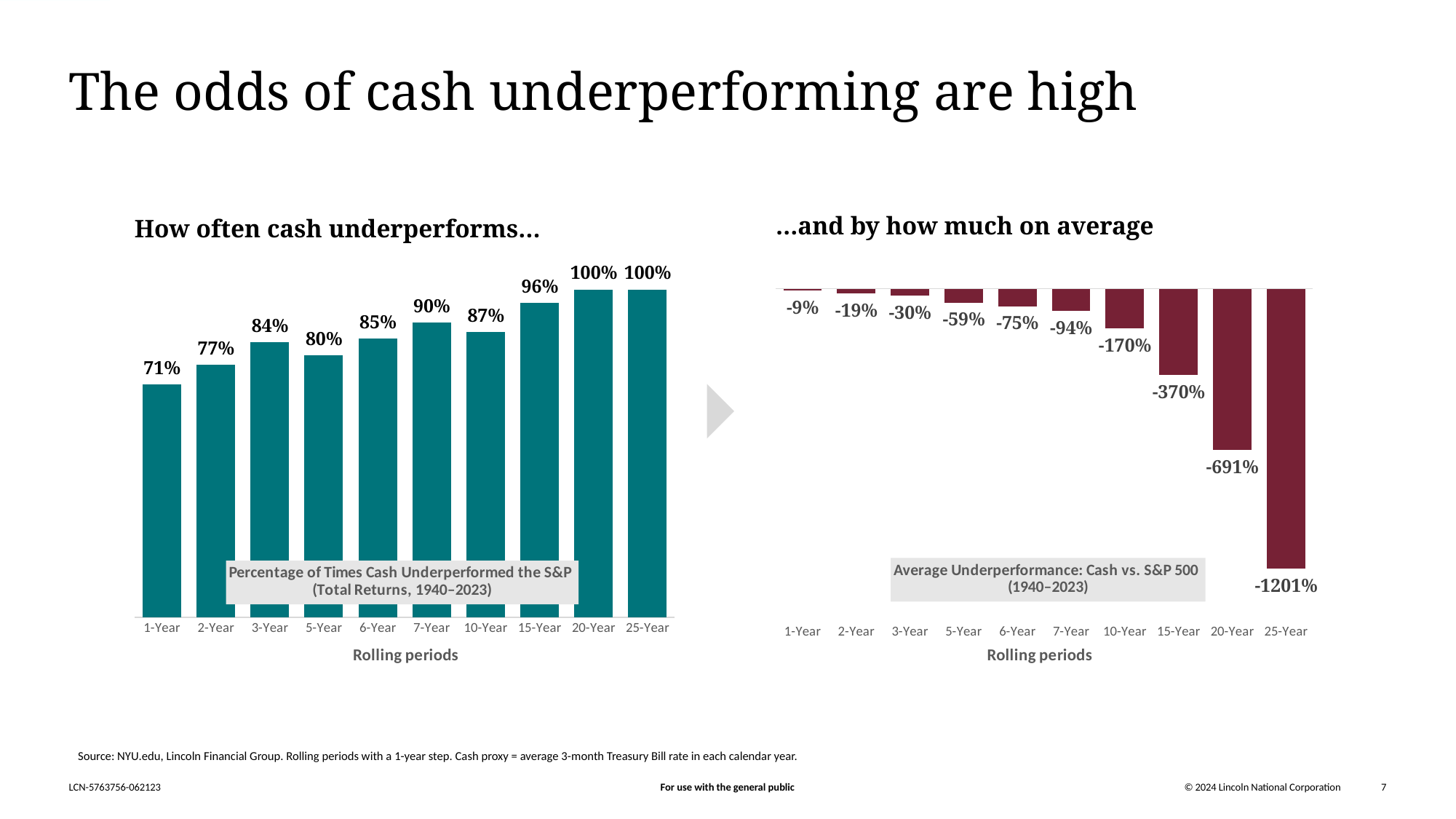
In the left chart 'How often cash underperforms...', what is the value for the 10-Year rolling period? 87% In the left chart 'How often cash underperforms...', what is the difference between the 15-Year and 1-Year values? 25% What kind of chart is the right chart '...and by how much on average'? Bar chart In the right chart '...and by how much on average', what is the difference between the 20-Year and 10-Year values? 521% How many rolling periods are shown on the x axis of the left chart 'How often cash underperforms...'? 10 In the left chart 'How often cash underperforms...', what is the value for the 3-Year rolling period? 84% In the left chart 'How often cash underperforms...', which is larger, the value for 7-Year or the value for 10-Year? 7-Year In the right chart '...and by how much on average', which rolling period has the largest underperformance (most negative value)? 25-Year What is the x-axis title of the left chart 'How often cash underperforms...'? Rolling periods In the right chart '...and by how much on average', what is the value for the 5-Year rolling period? -59% In the left chart 'How often cash underperforms...', which rolling period has the lowest value? 1-Year In the right chart '...and by how much on average', what is the value for the 15-Year rolling period? -370%